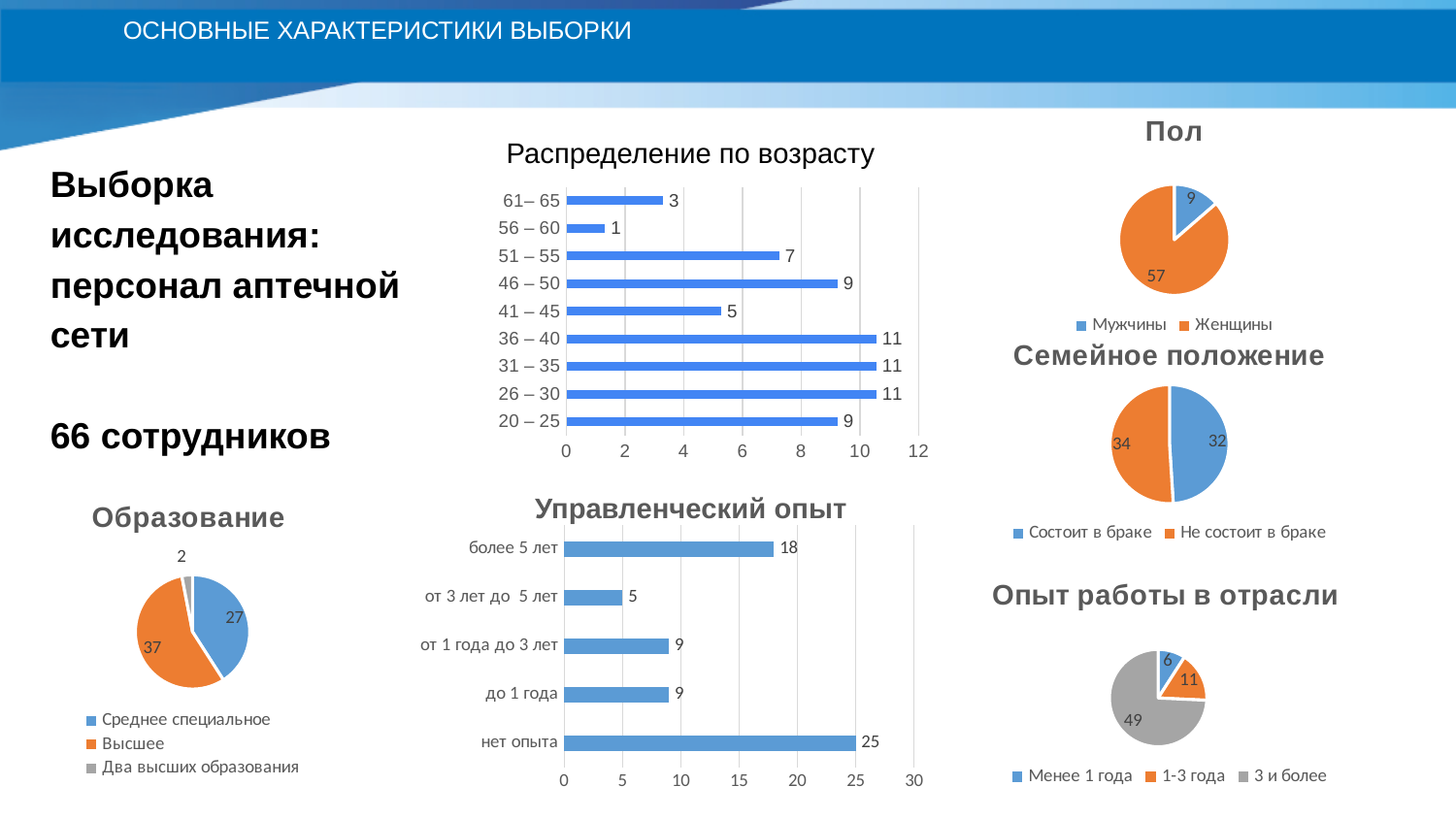
In the 'Управленческий опыт' chart, what is the value for 'более 5 лет'? 18 In the 'Управленческий опыт' chart, which category has the lowest value? от 3 лет до 5 лет In the 'Распределение по возрасту' chart, what is the difference between the values for 51 – 55 and 61– 65? 4 How many age groups are shown in the 'Распределение по возрасту' chart? 9 In the 'Распределение по возрасту' chart, which age group has the lowest value? 56 – 60 In the 'Управленческий опыт' chart, which category has the highest value? нет опыта In the 'Семейное положение' pie chart, which is larger: 'Состоит в браке' or 'Не состоит в браке'? Не состоит в браке In the 'Образование' pie chart, what is the value for 'Два высших образования'? 2 What type of chart is 'Управленческий опыт'? bar chart How many entries does the legend of the 'Опыт работы в отрасли' pie chart list? 3 In the 'Распределение по возрасту' chart, what is the value for the 46 – 50 age group? 9 In the 'Пол' pie chart, what is the value for 'Женщины'? 57